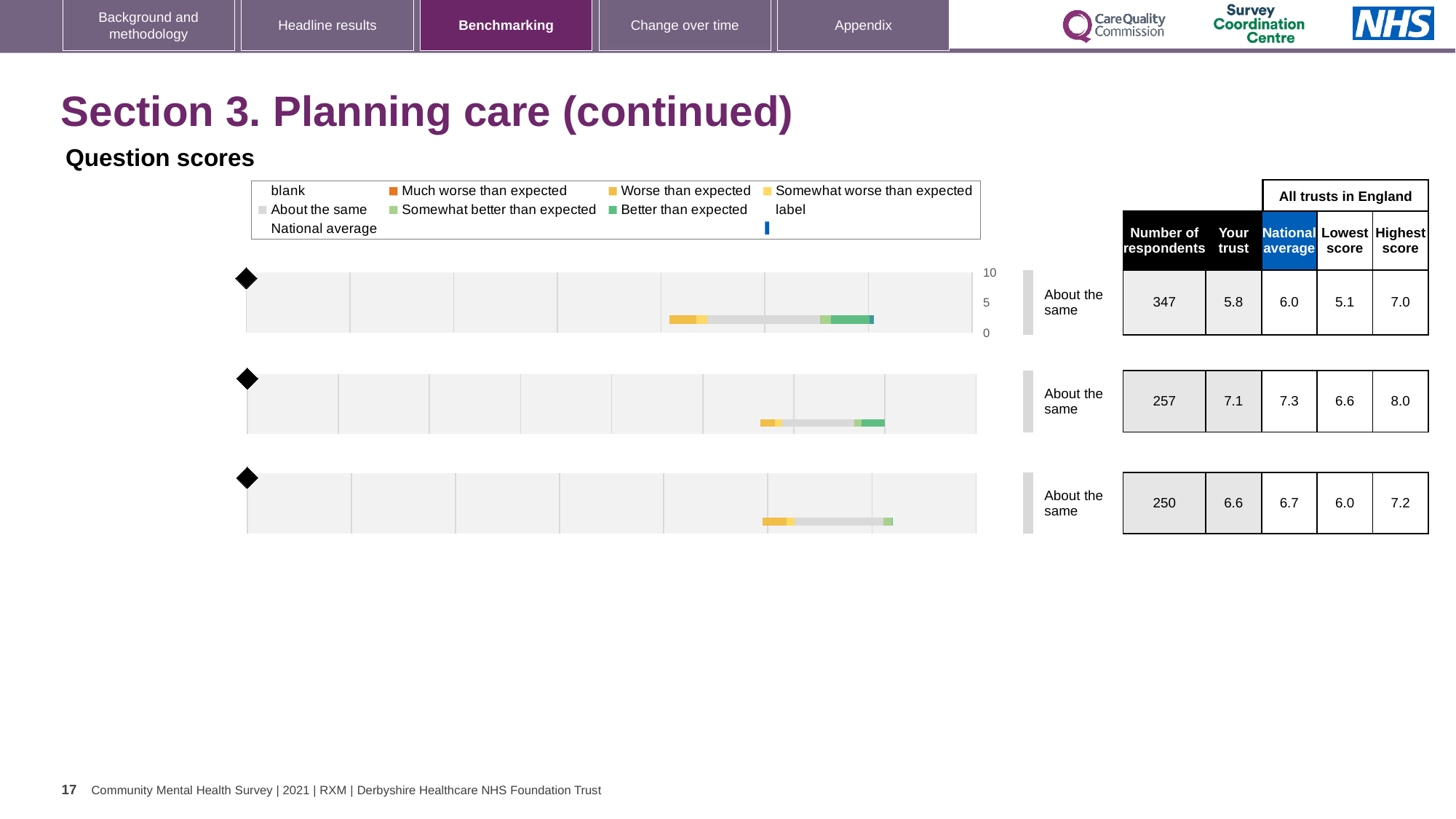
For the middle chart, what is the national average score? 7.3 What kind of chart is used to show the question scores on this slide? bar chart What benchmark category label is shown next to each of the three charts? About the same How many question score charts are shown on the slide? 3 For the top chart, what is the 'Your trust' score? 5.8 For the top chart, what is the number of respondents shown in the table? 347 For the top chart, which is larger: the 'Your trust' score or the national average? national average For the bottom chart, what is the highest score among all trusts in England? 7.2 Which chart (top, middle or bottom) has the lowest number of respondents? bottom Which chart (top, middle or bottom) has the highest 'Your trust' score? middle For the middle chart, what is the difference between the highest score and the lowest score? 1.4 What is the maximum value shown on the score axis of the top chart? 10